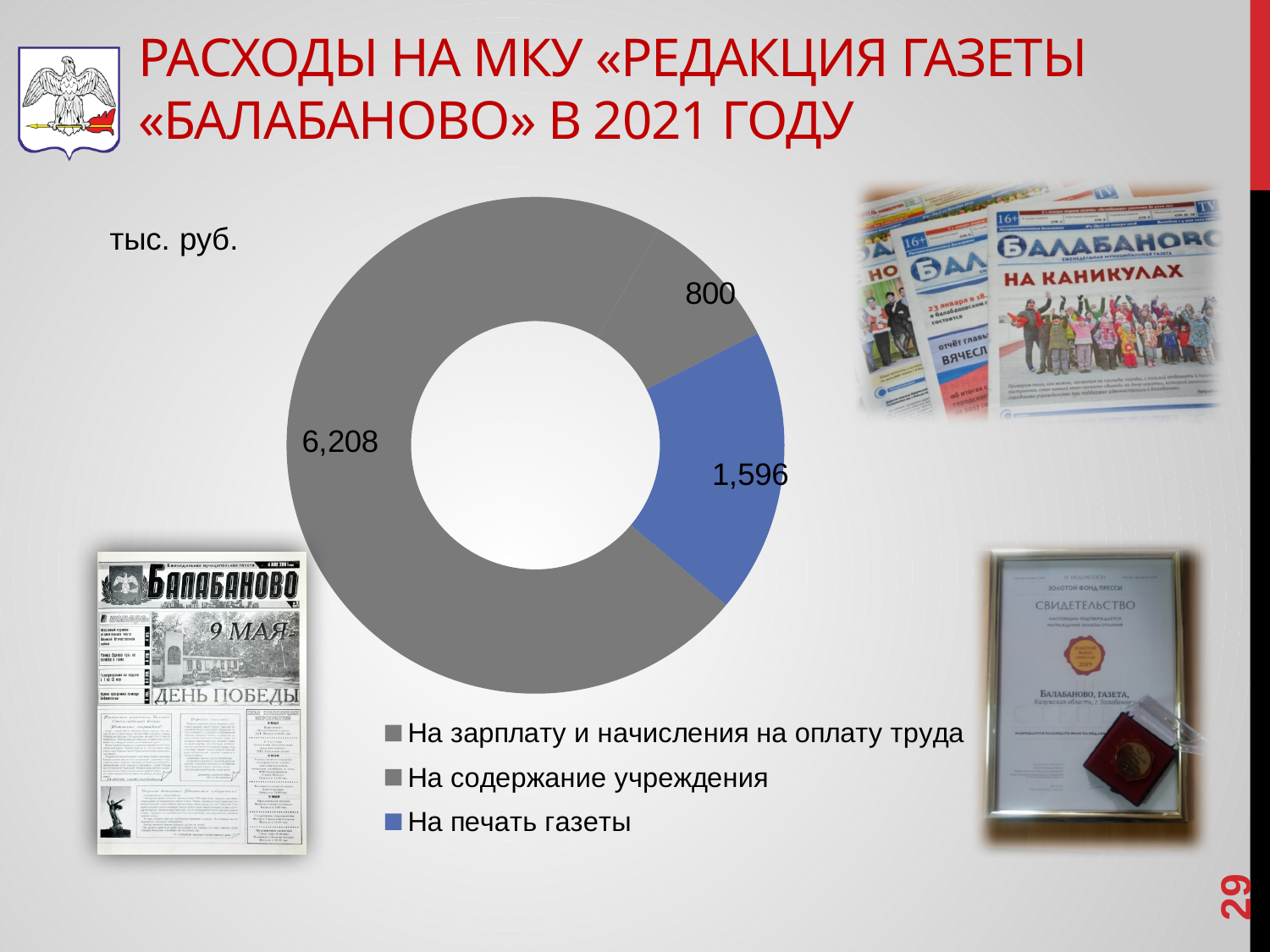
What is the difference between the largest slice (6,208) and the slice for «На печать газеты» (1,596)? 4,612 What is the total of all three slices on the doughnut chart? 8,604 How many entries does the chart legend list? 3 How many slices does the doughnut chart have? 3 Which legend entry is shown in blue? На печать газеты What unit of measurement is indicated for the chart values? тыс. руб. What is the value of the slice for «На печать газеты»? 1,596 What is the smallest value shown on the doughnut chart? 800 Which is larger: the slice labelled 1,596 or the slice labelled 800? 1,596 What kind of chart is shown on the slide? Doughnut (pie) chart What is the difference between the 1,596 slice and the 800 slice? 796 What is the largest value shown on the doughnut chart? 6,208